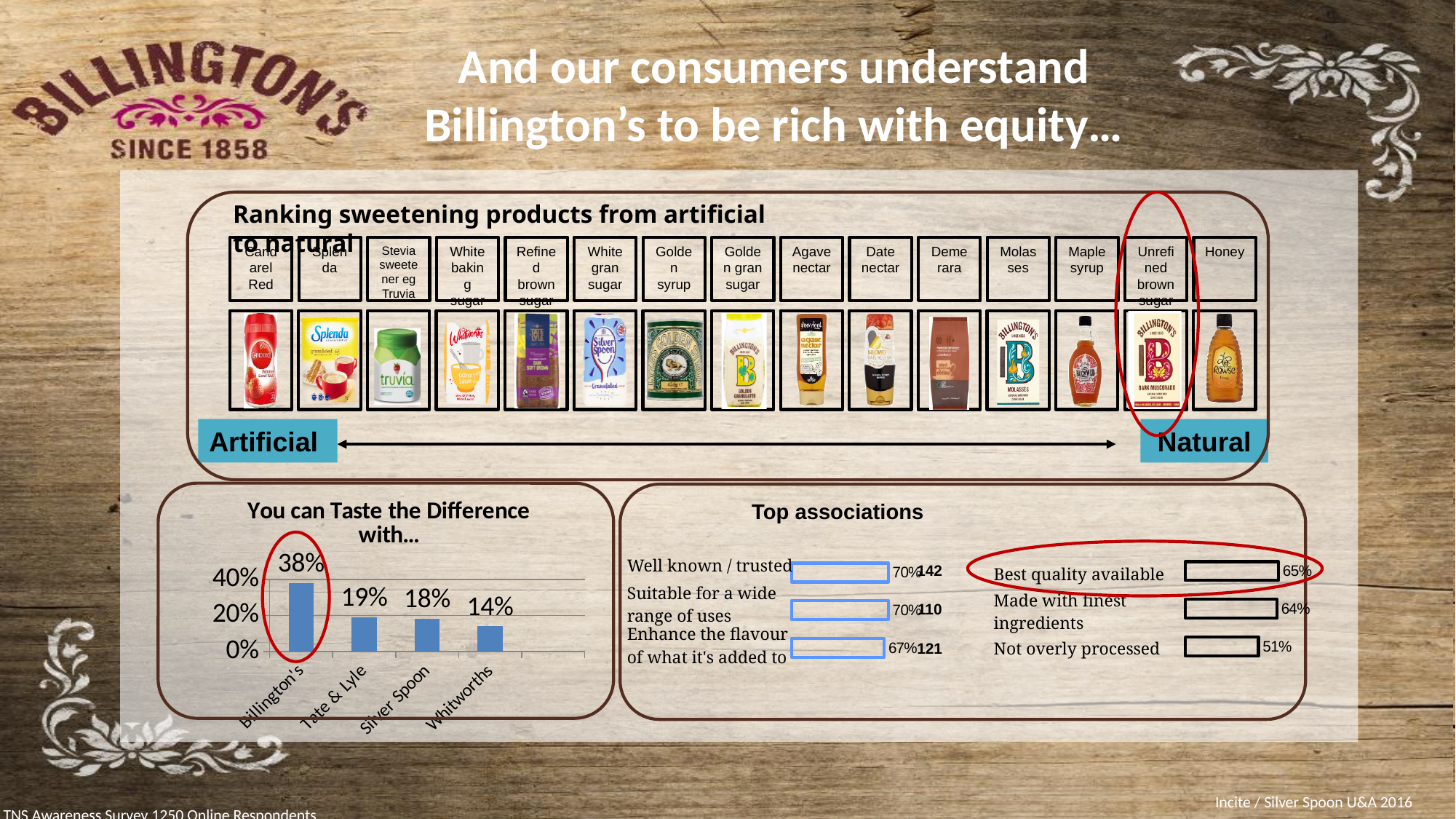
What kind of chart is the 'You can Taste the Difference with...' chart? bar chart In the 'You can Taste the Difference with...' chart, is the value for Billington's greater or less than 20%? greater In the 'You can Taste the Difference with...' chart, which brand has the highest value? Billington's In the 'You can Taste the Difference with...' chart, what is the value for Tate & Lyle? 19% In the 'You can Taste the Difference with...' chart, what is the value for Billington's? 38% In the 'You can Taste the Difference with...' chart, which brand has the lowest value? Whitworths In the 'Top associations' panel, what percentage is shown for 'Best quality available'? 65% In the 'You can Taste the Difference with...' chart, which is larger, the value for Billington's or the value for Tate & Lyle? Billington's In the 'You can Taste the Difference with...' chart, what is the value for Silver Spoon? 18% How many brands are shown in the 'You can Taste the Difference with...' chart? 4 In the 'You can Taste the Difference with...' chart, what is the value for Whitworths? 14% In the 'You can Taste the Difference with...' chart, what is the difference between the values for Billington's and Whitworths? 24%